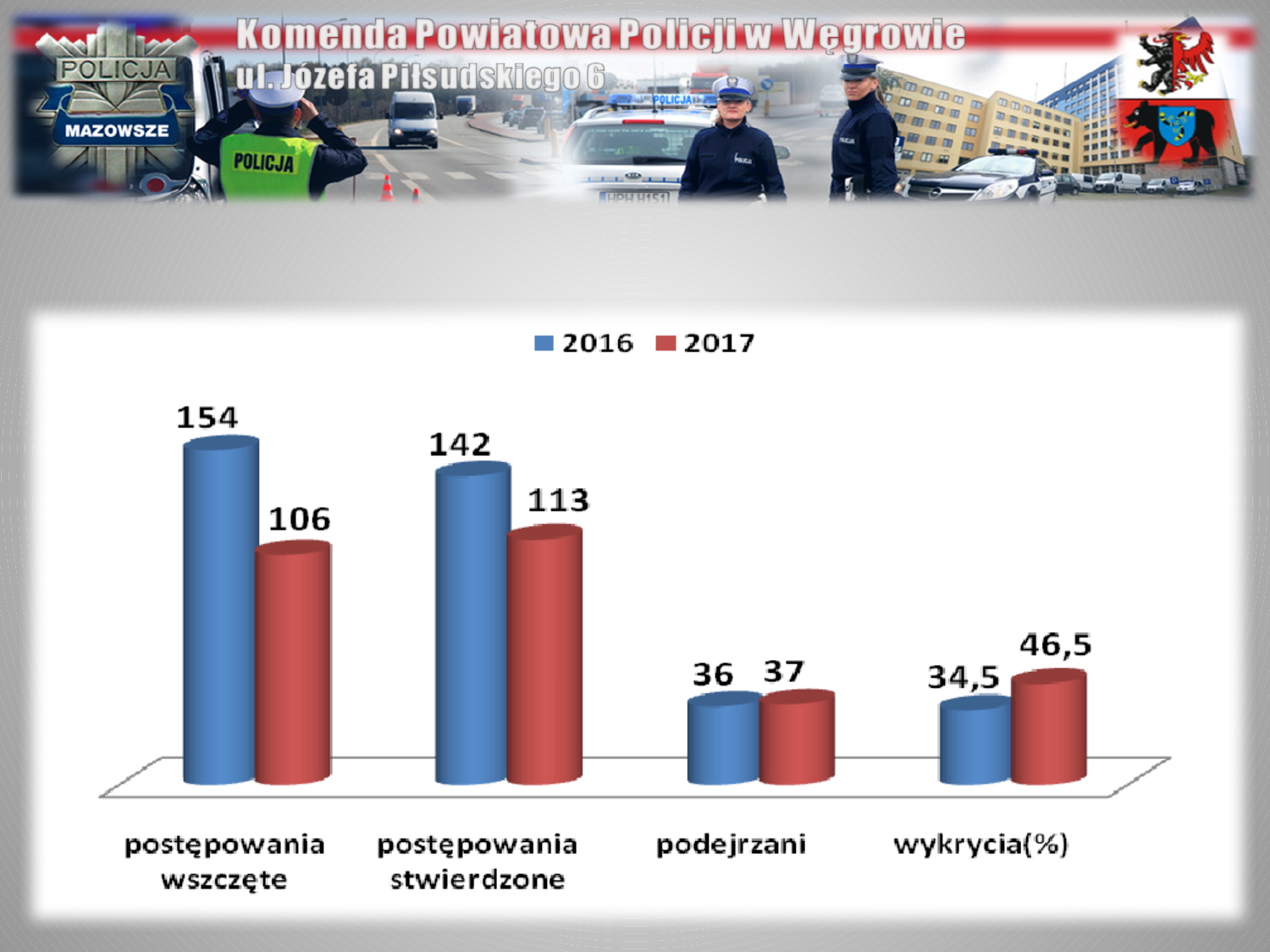
Which is larger in the 'wykrycia(%)' category, the 2016 value or the 2017 value? 2017 What kind of chart is shown on the slide? bar chart What is the difference between the 2016 and 2017 values for 'postępowania wszczęte'? 48 How many series does the legend list? 2 Which category has the lowest value for the 2017 series? podejrzani What is the value for 2016 in the 'podejrzani' category? 36 What is the value for 2017 in the 'wykrycia(%)' category? 46,5 What is the difference between the 2016 and 2017 values for 'postępowania stwierdzone'? 29 What is the value for 2017 in the 'postępowania stwierdzone' category? 113 What is the value for 2016 in the 'postępowania wszczęte' category? 154 Which category has the highest value for the 2016 series? postępowania wszczęte How many categories are shown on the x axis? 4